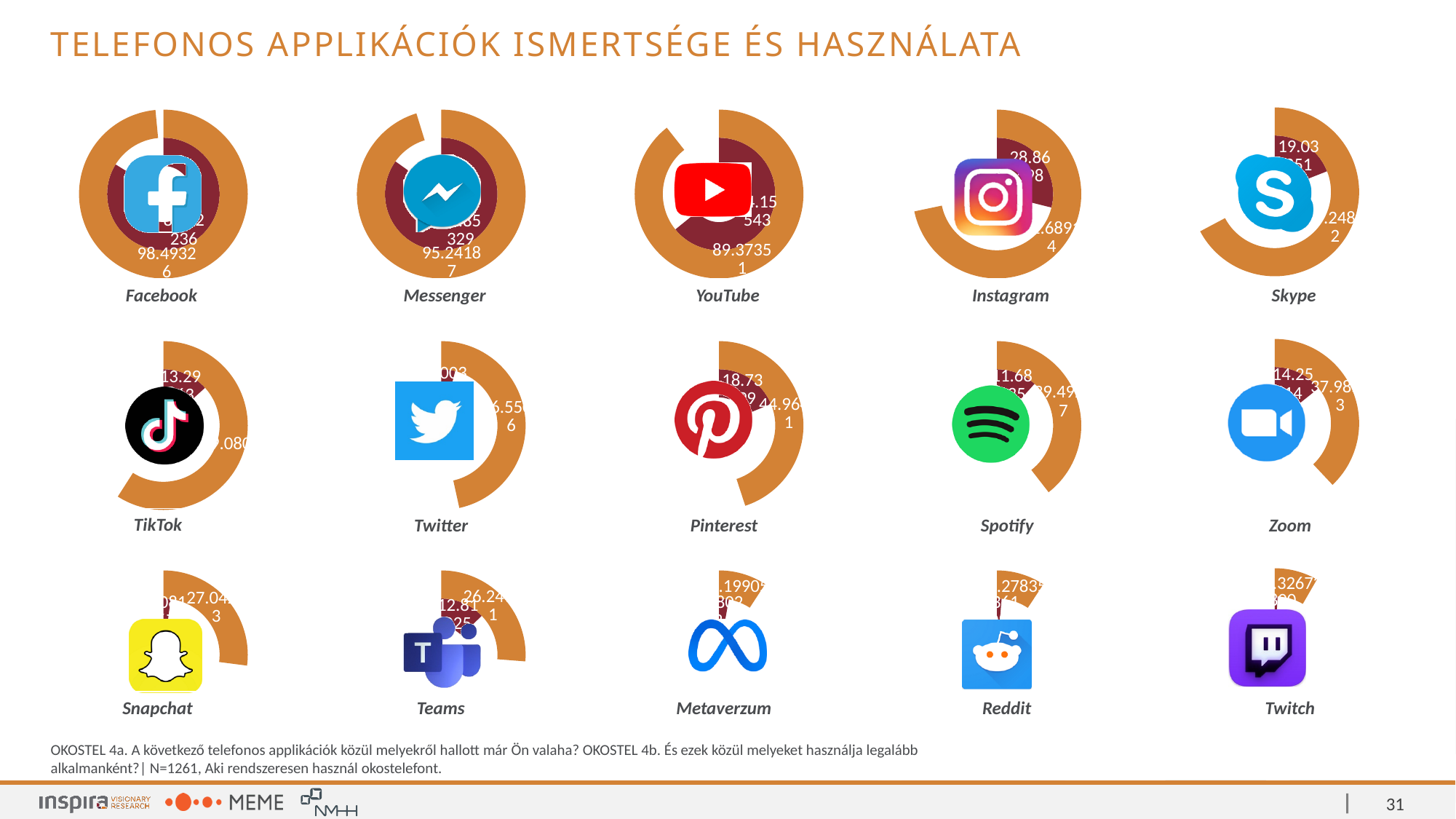
What value is printed at the top of the Pinterest chart? 18.73 What value is printed at the top of the Zoom chart? 14.25 What is the title of the slide? TELEFONOS APPLIKÁCIÓK ISMERTSÉGE ÉS HASZNÁLATA Which app has a larger outer ring value, Facebook or Twitch? Facebook What is the sample size (N) stated in the footnote of the slide? N=1261 What kind of chart is used for each app on the slide? Donut (pie) chart What value is printed at the top of the Skype chart? 19.03 How many donut charts are shown on the slide? 15 What value is printed at the top of the TikTok chart? 13.29 Which app has a larger outer ring value, YouTube or Snapchat? YouTube Which app's chart has the largest (most complete) outer ring? Facebook What value is printed at the top of the Instagram chart? 28.86